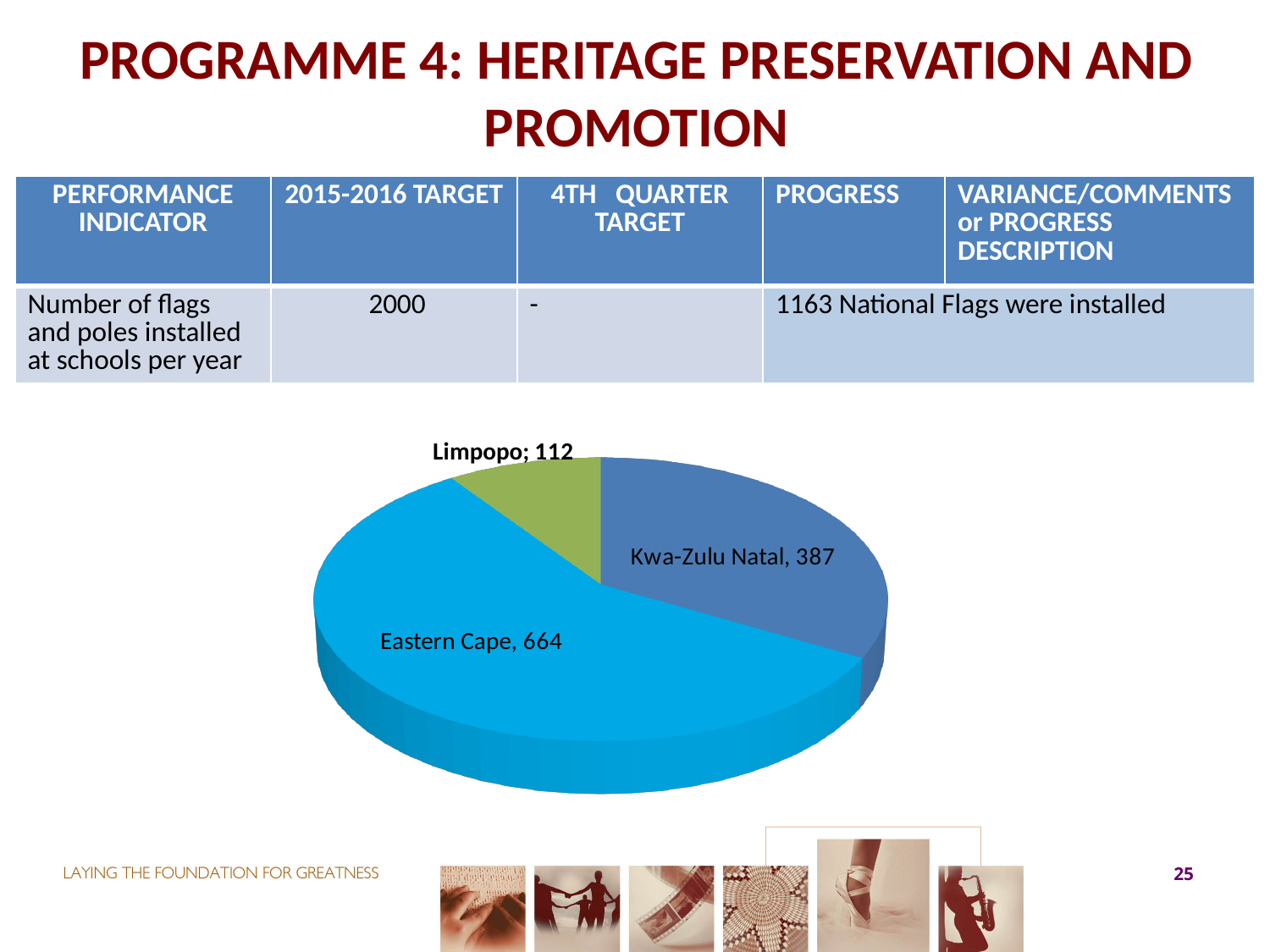
What is the value for Kwa-Zulu Natal in the pie chart? 387 What is the difference between the values for Eastern Cape and Kwa-Zulu Natal? 277 Which province has the largest slice in the pie chart? Eastern Cape What is the difference between the values for Kwa-Zulu Natal and Limpopo? 275 How many slices does the pie chart have? 3 Which is larger, the value for Kwa-Zulu Natal or the value for Limpopo? Kwa-Zulu Natal Which province has the smallest slice in the pie chart? Limpopo What kind of chart is shown on the slide? Pie chart What is the value for Limpopo in the pie chart? 112 What is the value for Eastern Cape in the pie chart? 664 What colour is the Eastern Cape slice in the pie chart? Light blue What is the total of all three slices in the pie chart? 1163